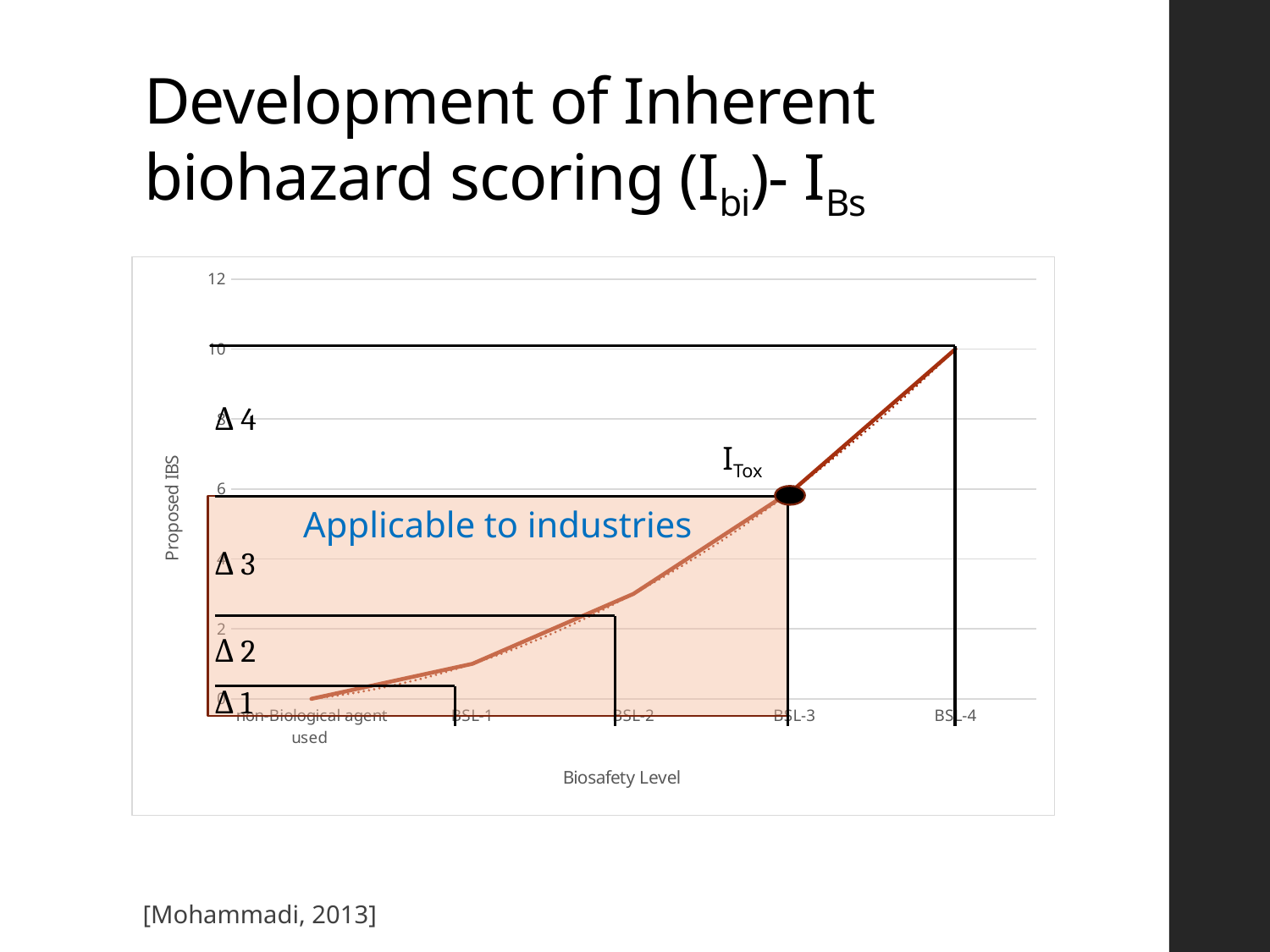
What kind of chart is shown on the slide? line chart Which biosafety level has the highest Proposed IBS? BSL-4 Is the Proposed IBS value for BSL-2 greater or less than 4? less How many biosafety level categories are shown on the x axis? 5 Which category has the lowest Proposed IBS? non-Biological agent used What is the difference between the Proposed IBS at BSL-4 and at BSL-3? 4 What is the Proposed IBS value at BSL-4? 10 What is the Proposed IBS value at BSL-3? 6 Is the Proposed IBS value for BSL-1 greater or less than 2? less Does the Proposed IBS rise or fall as the biosafety level increases from non-Biological agent used to BSL-4? rise Which has a larger Proposed IBS, BSL-3 or BSL-1? BSL-3 What is the title of the y axis? Proposed IBS